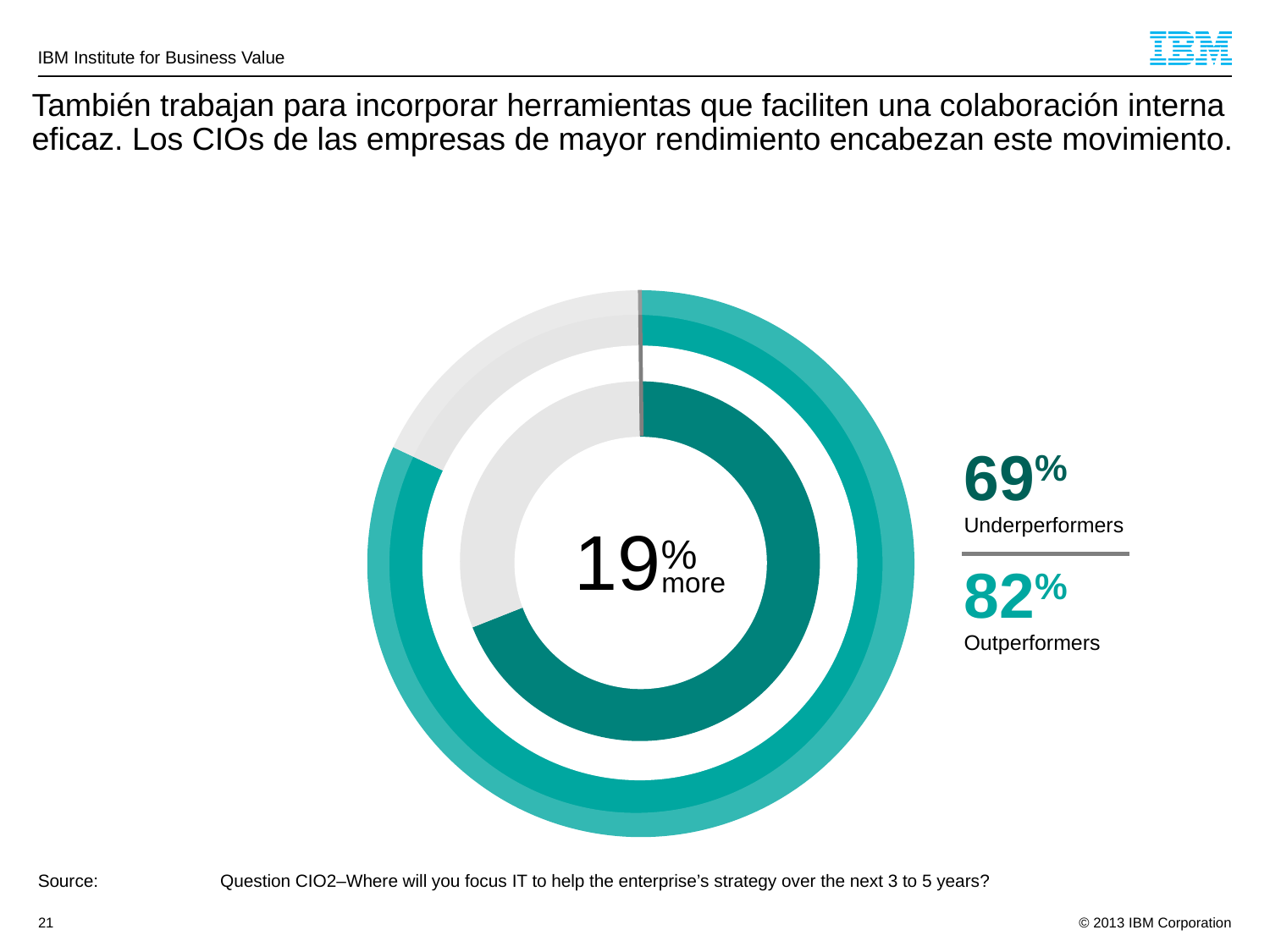
What text is printed in the center of the donut chart? 19% more Which group is represented by the outer, lighter teal ring of the chart? Outperformers Which group has the highest percentage shown on the chart? Outperformers By how many percentage points does the Outperformers value exceed the Underperformers value? 13 percentage points What kind of chart is shown on the slide? Donut chart Which group has the higher percentage, Outperformers or Underperformers? Outperformers How many groups are compared in the chart? 2 What percentage is shown for Underperformers? 69% Which group has the lowest percentage shown on the chart? Underperformers What percentage is shown for Outperformers? 82%